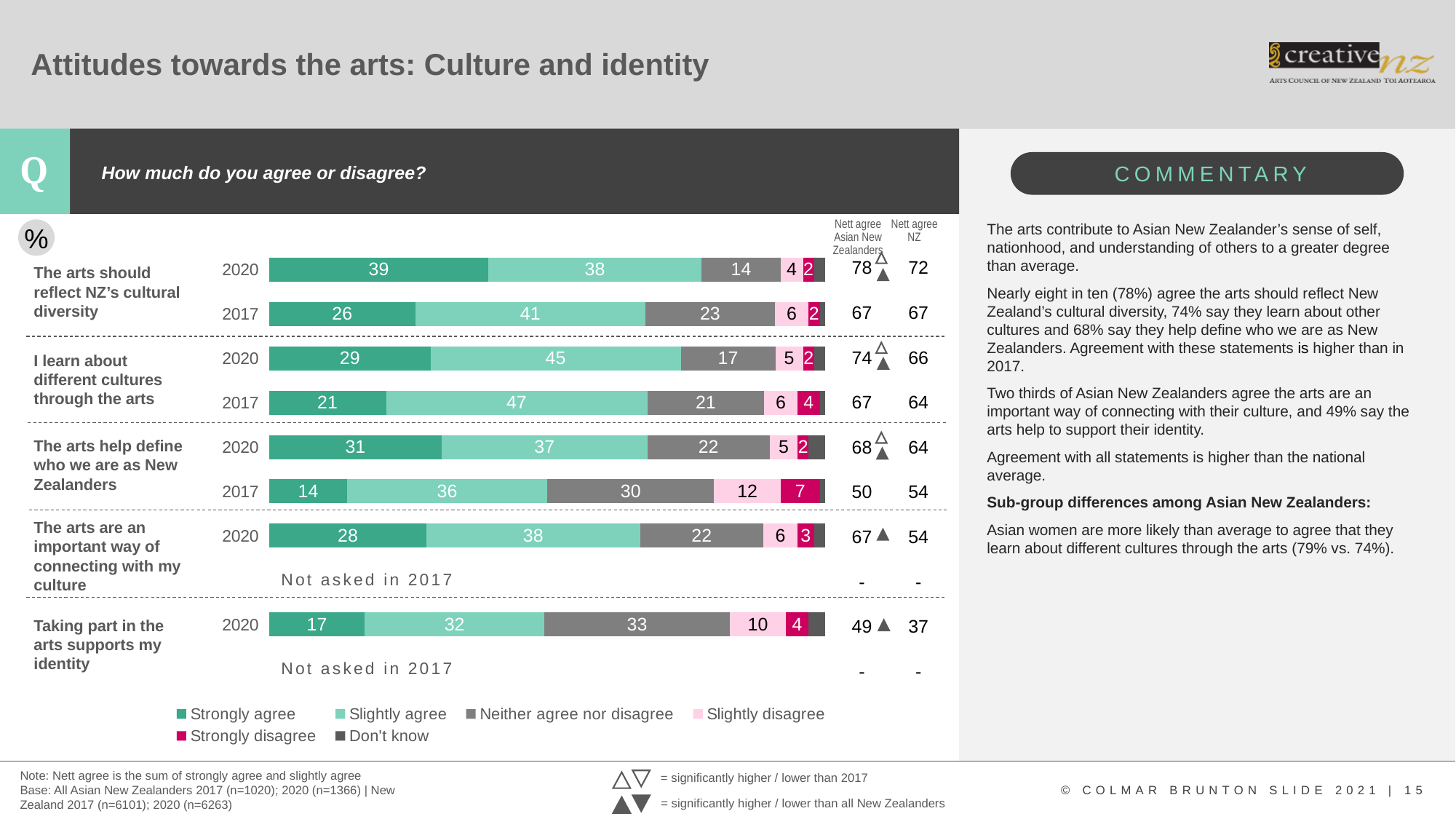
What is the 'Neither agree nor disagree' value for 'Taking part in the arts supports my identity' in 2020? 33 What is the 'Strongly disagree' value for 'The arts help define who we are as New Zealanders' in 2017? 7 By how many points did the 'Strongly agree' value for 'The arts help define who we are as New Zealanders' change from 2017 to 2020? 17 Which statement has the highest 'Strongly agree' value in 2020? The arts should reflect NZ's cultural diversity What is the Nett agree figure for Asian New Zealanders for 'The arts help define who we are as New Zealanders' in 2020? 68 What kind of chart is shown on the slide? Stacked bar chart Which statement has the lowest 'Strongly agree' value in 2020? Taking part in the arts supports my identity How many statements are shown in the chart? 5 How many series does the legend list? 6 What percentage of Asian New Zealanders strongly agreed in 2020 that the arts should reflect NZ's cultural diversity? 39 What is the 'Slightly agree' value for 'I learn about different cultures through the arts' in 2017? 47 Which is larger: the 2020 'Slightly agree' value for 'I learn about different cultures through the arts' or for 'The arts are an important way of connecting with my culture'? I learn about different cultures through the arts